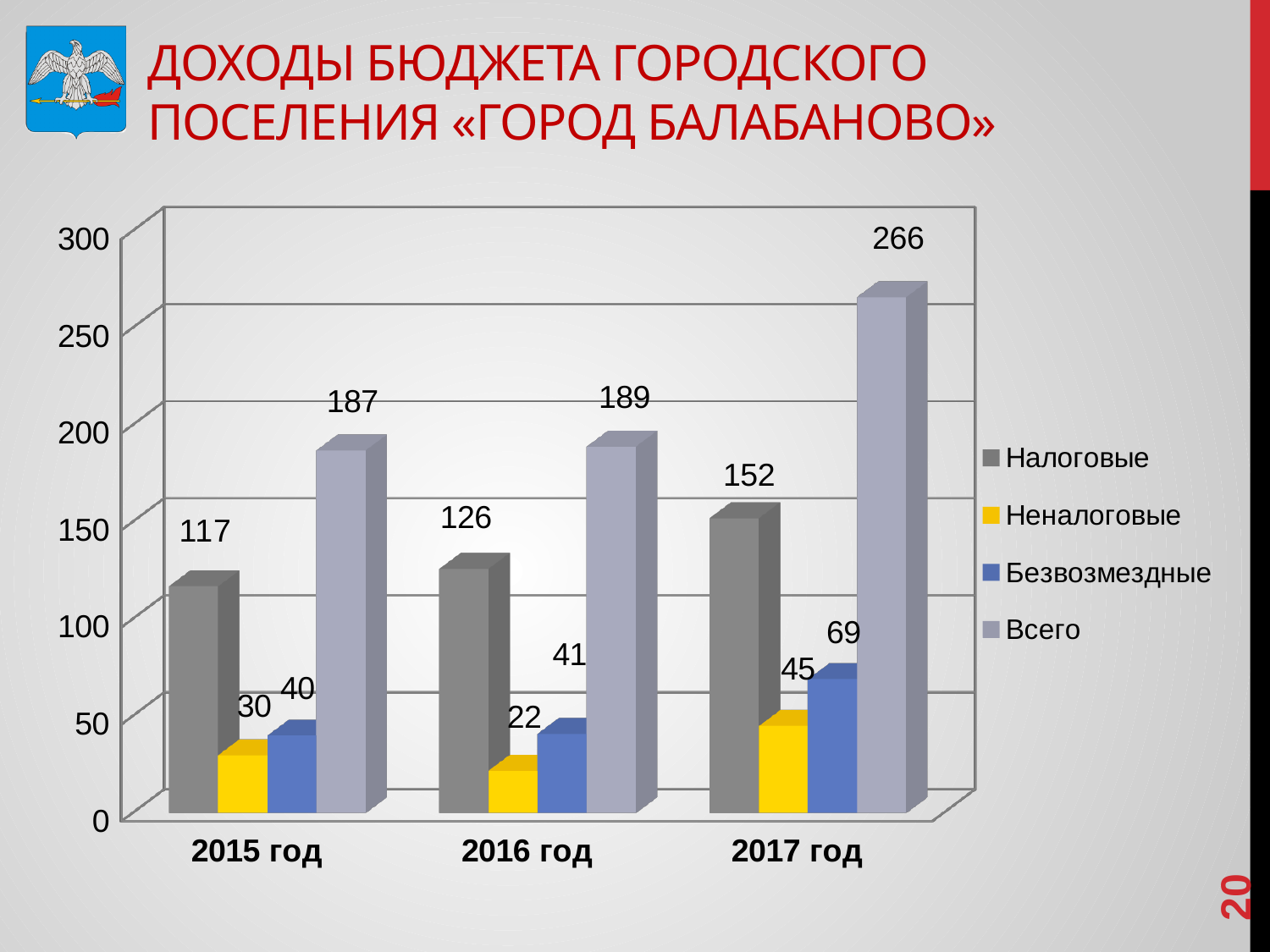
What is the value of Всего for 2017 год? 266 What is the value of Неналоговые for 2016 год? 22 What kind of chart is shown on the slide? bar chart Which is larger: Безвозмездные in 2016 год or Неналоговые in 2017 год? Неналоговые in 2017 год What is the difference between Всего in 2017 год and Всего in 2016 год? 77 How many year categories are shown on the x axis? 3 What is the value of Безвозмездные for 2017 год? 69 How many series does the legend list? 4 What is the value of Налоговые for 2015 год? 117 Do the Налоговые values rise or fall from 2015 год to 2017 год? rise In which year is Неналоговые the lowest? 2016 год In which year is Всего the highest? 2017 год